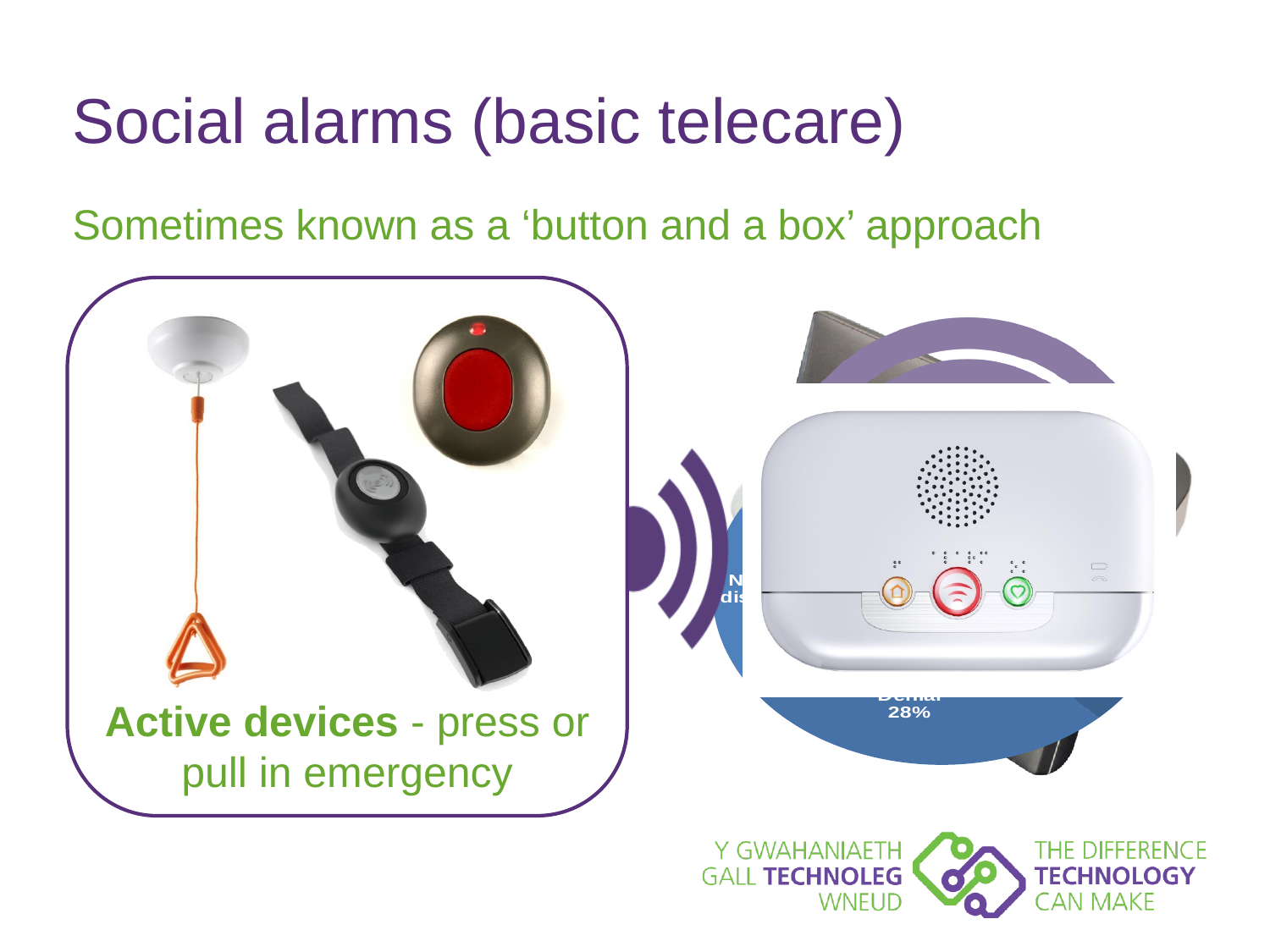
What is the main colour of the pie chart on the right of the slide? blue In the pie chart on the right of the slide, what percentage is shown for the Denial slice? 28% What kind of chart is partially visible behind the telecare box image on the right of the slide? pie chart